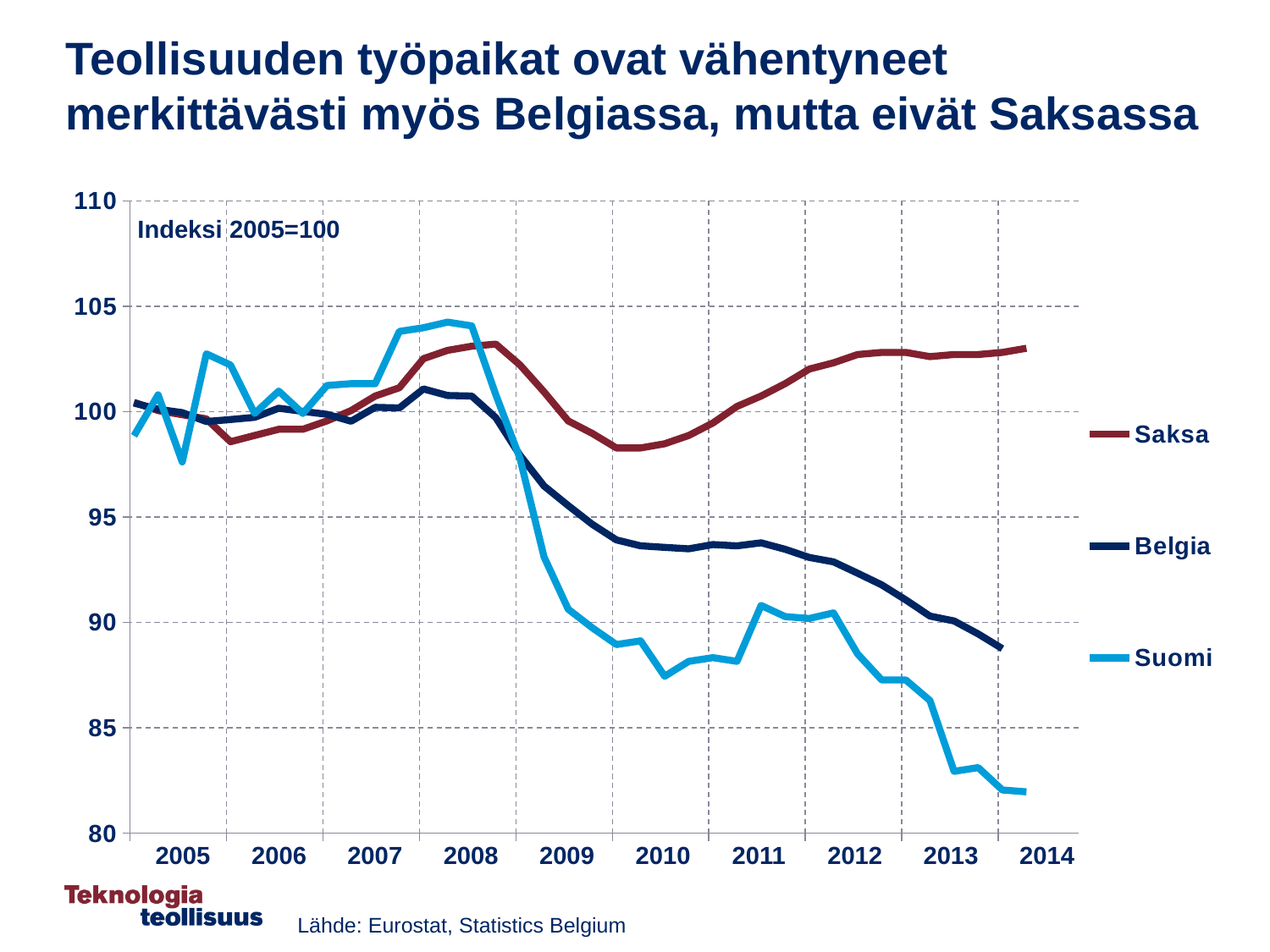
Which series has the highest value at the end of the chart (2014)? Saksa Is the value for Belgia at 2010 greater or less than 95? less What kind of chart is shown on the slide? Line chart What index base is stated on the chart? Indeksi 2005=100 Is the value for Saksa at the end of 2013 greater or less than 100? greater Which series has the lowest value at the end of the chart (2014)? Suomi Is the value for Suomi at 2008 greater or less than 100? greater At 2012, which is higher, Belgia or Suomi? Belgia How many series does the legend list? 3 Does the Suomi line rise or fall from 2009 to 2014? Fall Does the Saksa line rise or fall from 2010 to 2012? Rise